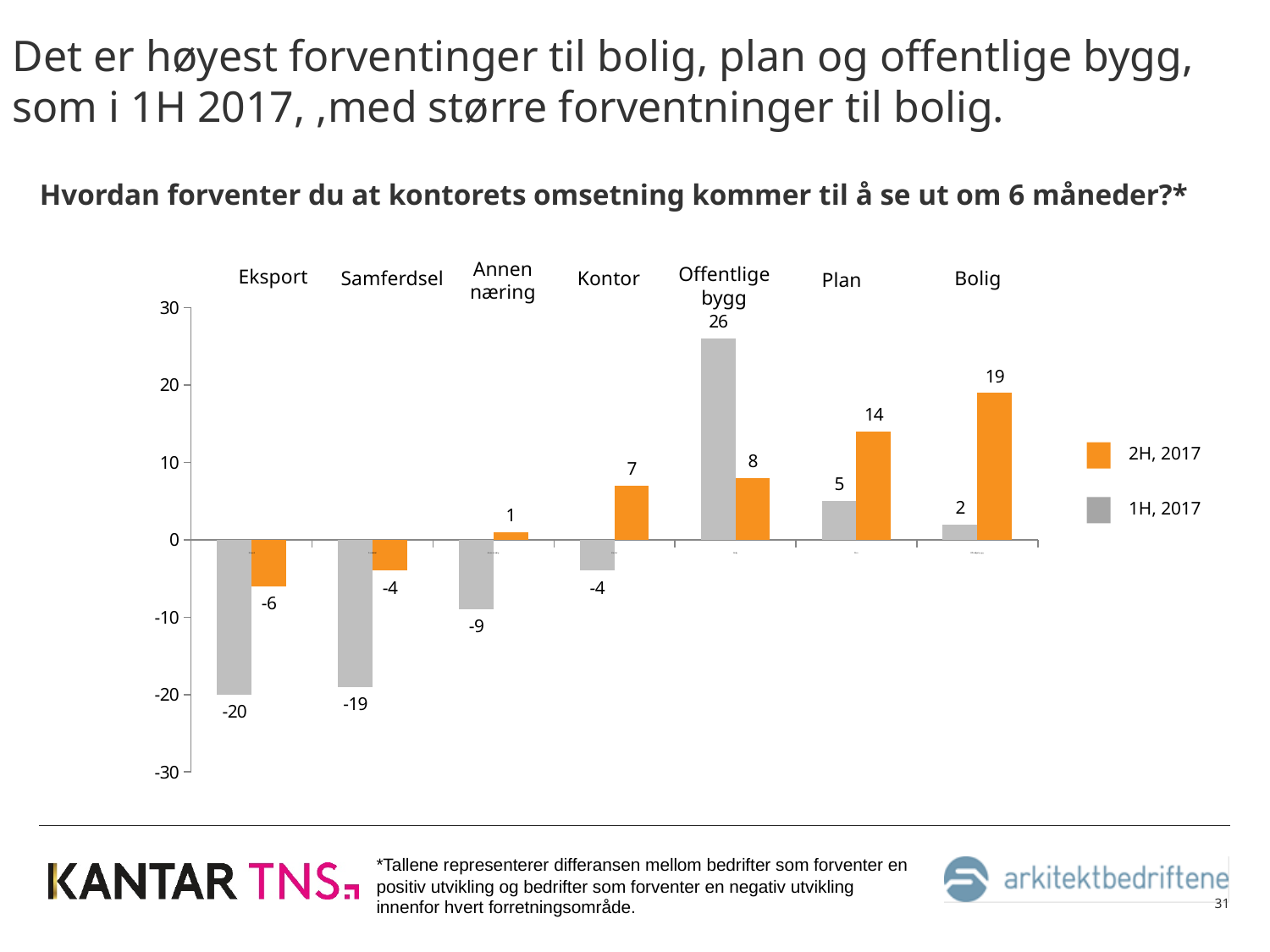
How many categories are shown on the x axis? 7 What is the value for Offentlige bygg in the 1H, 2017 series? 26 Which is larger for Plan: the 1H, 2017 value or the 2H, 2017 value? 2H, 2017 What is the value for Bolig in the 2H, 2017 series? 19 What kind of chart is shown on the slide? Bar chart What is the difference between the 2H, 2017 and 1H, 2017 values for Bolig? 17 What is the value for Eksport in the 1H, 2017 series? -20 Which category has the lowest value in the 1H, 2017 series? Eksport What is the value for Kontor in the 2H, 2017 series? 7 Which colour represents the 2H, 2017 series in the legend? Orange Which category has the highest value in the 2H, 2017 series? Bolig How many series does the legend list? 2